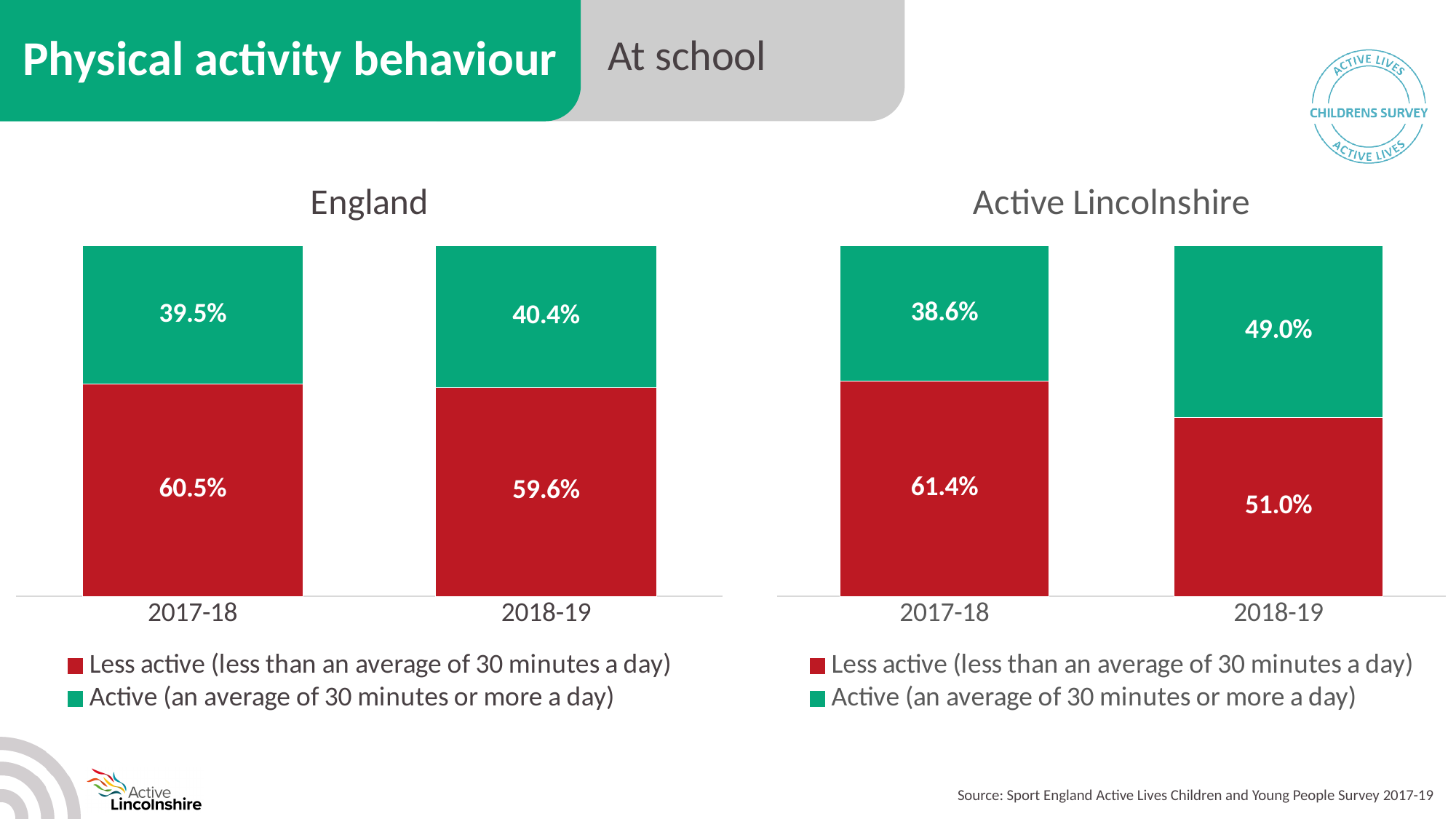
What kind of chart is the England chart? Stacked bar chart In the England chart, what is the value for Less active (less than an average of 30 minutes a day) in 2018-19? 59.6% In the Active Lincolnshire chart, what is the difference between the Less active values for 2017-18 and 2018-19? 10.4% In the Active Lincolnshire chart, which year has the higher Active (an average of 30 minutes or more a day) value? 2018-19 In the Active Lincolnshire chart, what is the value for Active (an average of 30 minutes or more a day) in 2018-19? 49.0% In the England chart, is the Less active value for 2017-18 larger or smaller than the Less active value for 2018-19? larger In the England chart, what is the value for Active (an average of 30 minutes or more a day) in 2017-18? 39.5% In the Active Lincolnshire chart, what is the value for Less active (less than an average of 30 minutes a day) in 2017-18? 61.4% How many series does the legend of the England chart list? 2 How many categories are shown on the x axis of the Active Lincolnshire chart? 2 In the Active Lincolnshire chart, what is the total of the stacked bar for 2018-19? 100.0% In the England chart, what is the difference between the Active values for 2018-19 and 2017-18? 0.9%